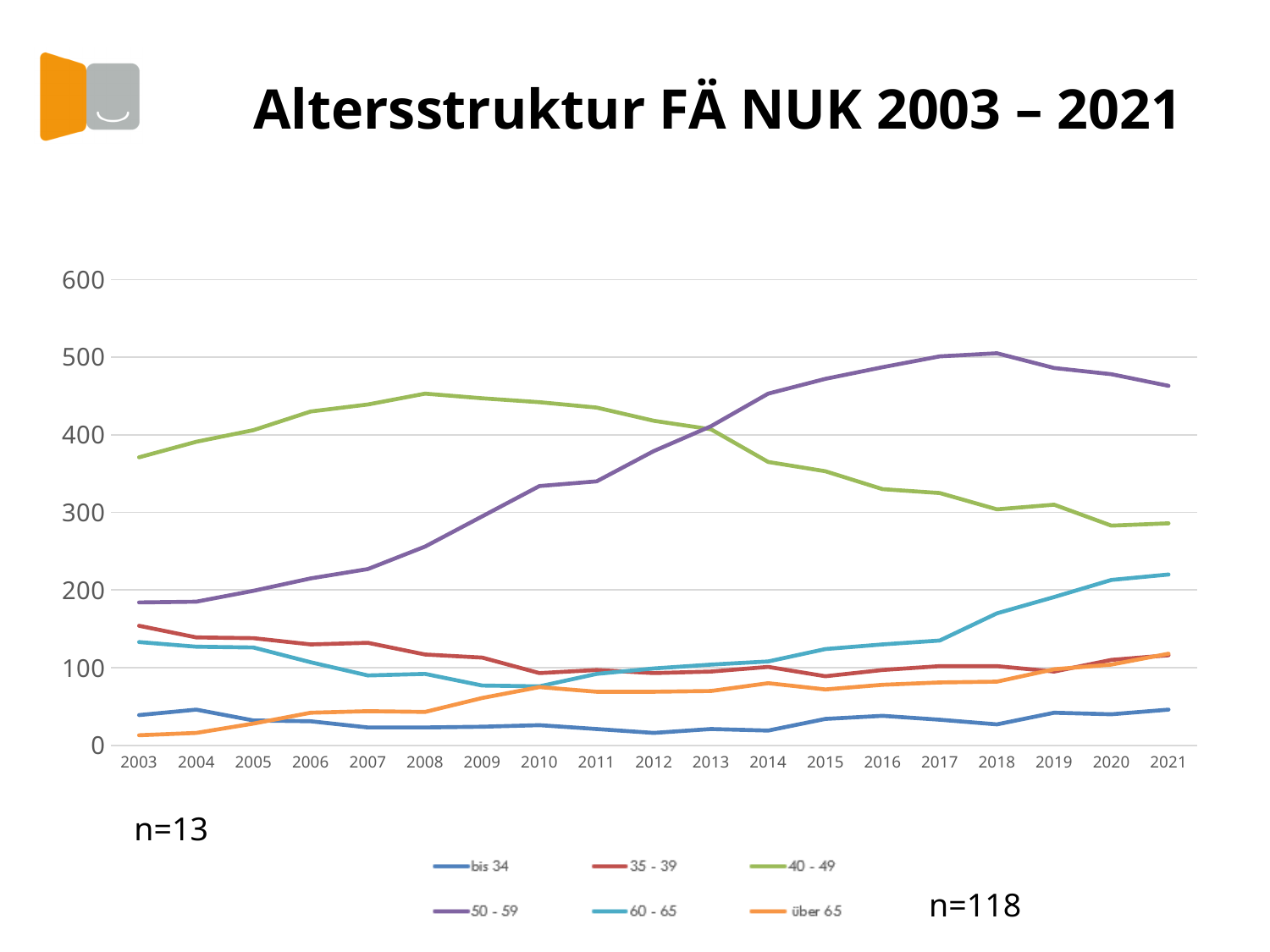
In 2021, which is larger: the 50 - 59 series or the 40 - 49 series? 50 - 59 Is the value for the 60 - 65 series in 2021 greater or less than 200? greater What is the title of the chart? Altersstruktur FÄ NUK 2003 – 2021 Does the 40 - 49 series rise or fall from 2008 to 2021? fall Which series has the lowest value in 2003? über 65 What kind of chart is shown on the slide? line chart Is the value for the bis 34 series in 2021 greater or less than 100? less How many series does the legend list? 6 In 2003, which is larger: the 40 - 49 series or the 50 - 59 series? 40 - 49 How many years are shown along the x axis? 19 Is the value for the 50 - 59 series in 2018 greater or less than 400? greater